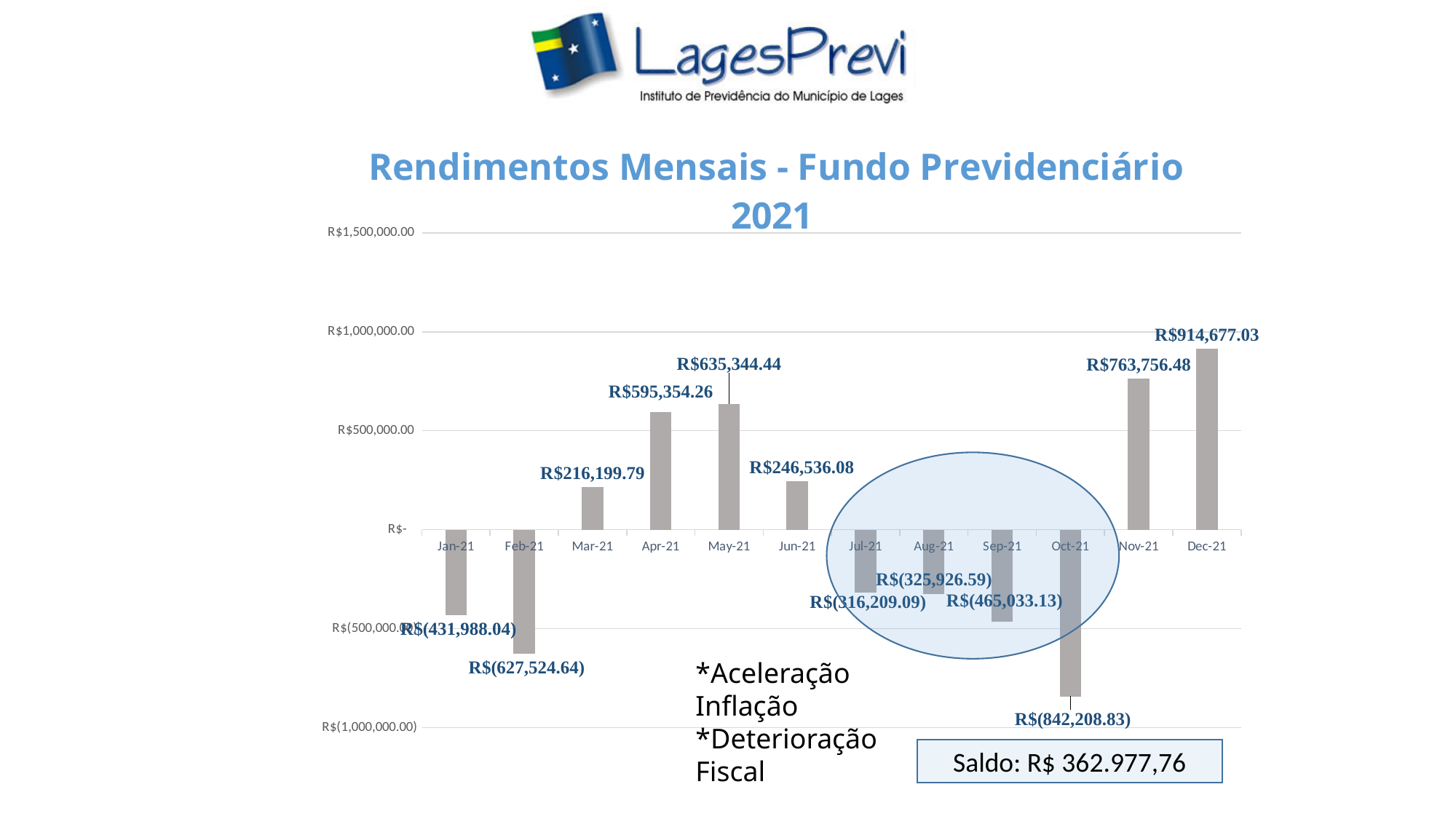
Is the value for Nov-21 greater or less than R$500,000.00? greater What is the value for Mar-21? R$216,199.79 What is the title of the chart? Rendimentos Mensais - Fundo Previdenciário 2021 Which month has the lowest value? Oct-21 What kind of chart is shown on the slide? bar chart Which month has the highest value? Dec-21 How many months are plotted on the chart? 12 Which is larger, the value for Apr-21 or the value for May-21? May-21 What is the value for Feb-21? R$(627,524.64) What is the value for Oct-21? R$(842,208.83) What is the difference between the values for Dec-21 and Nov-21? R$150,920.55 What is the value for Dec-21? R$914,677.03